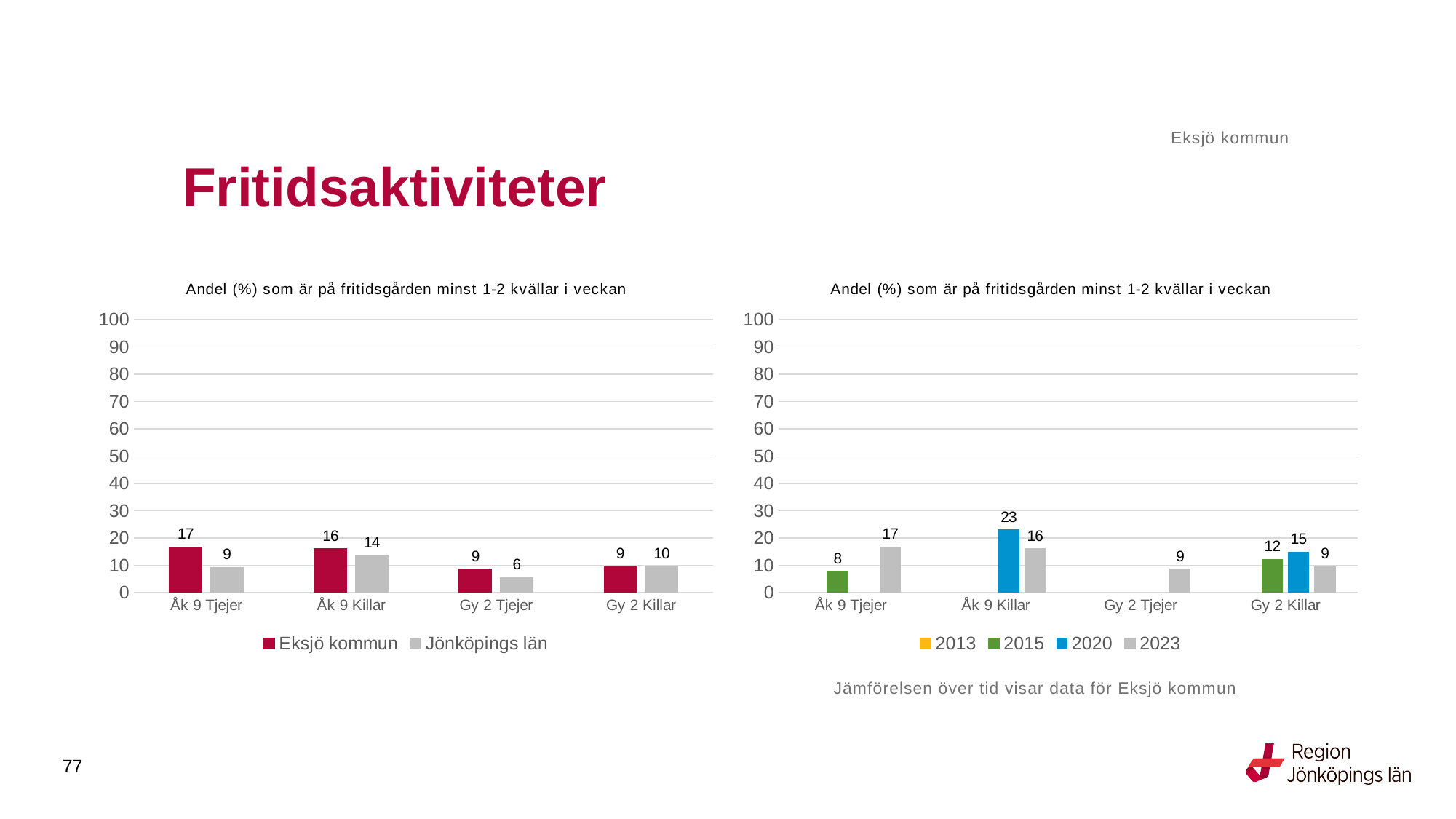
How many series does the legend of the right chart list? 4 In the right chart, what is the value for 2020 for Åk 9 Killar? 23 In the left chart, what is the value for Jönköpings län for Gy 2 Tjejer? 6 In the left chart, which category has the highest value for Jönköpings län? Åk 9 Killar In the left chart, what is the difference between Eksjö kommun and Jönköpings län for Åk 9 Tjejer? 8 In the right chart, which category has the lowest value for 2023? Gy 2 Tjejer and Gy 2 Killar (both 9) In the right chart, what is the difference between the 2020 and 2023 values for Åk 9 Killar? 7 In the left chart, which is larger for Gy 2 Killar: Eksjö kommun or Jönköpings län? Jönköpings län What type of chart is the right chart? Bar chart In the left chart, what is the value for Eksjö kommun for Åk 9 Tjejer? 17 In the right chart, what is the value for 2015 for Gy 2 Killar? 12 How many series does the legend of the left chart list? 2